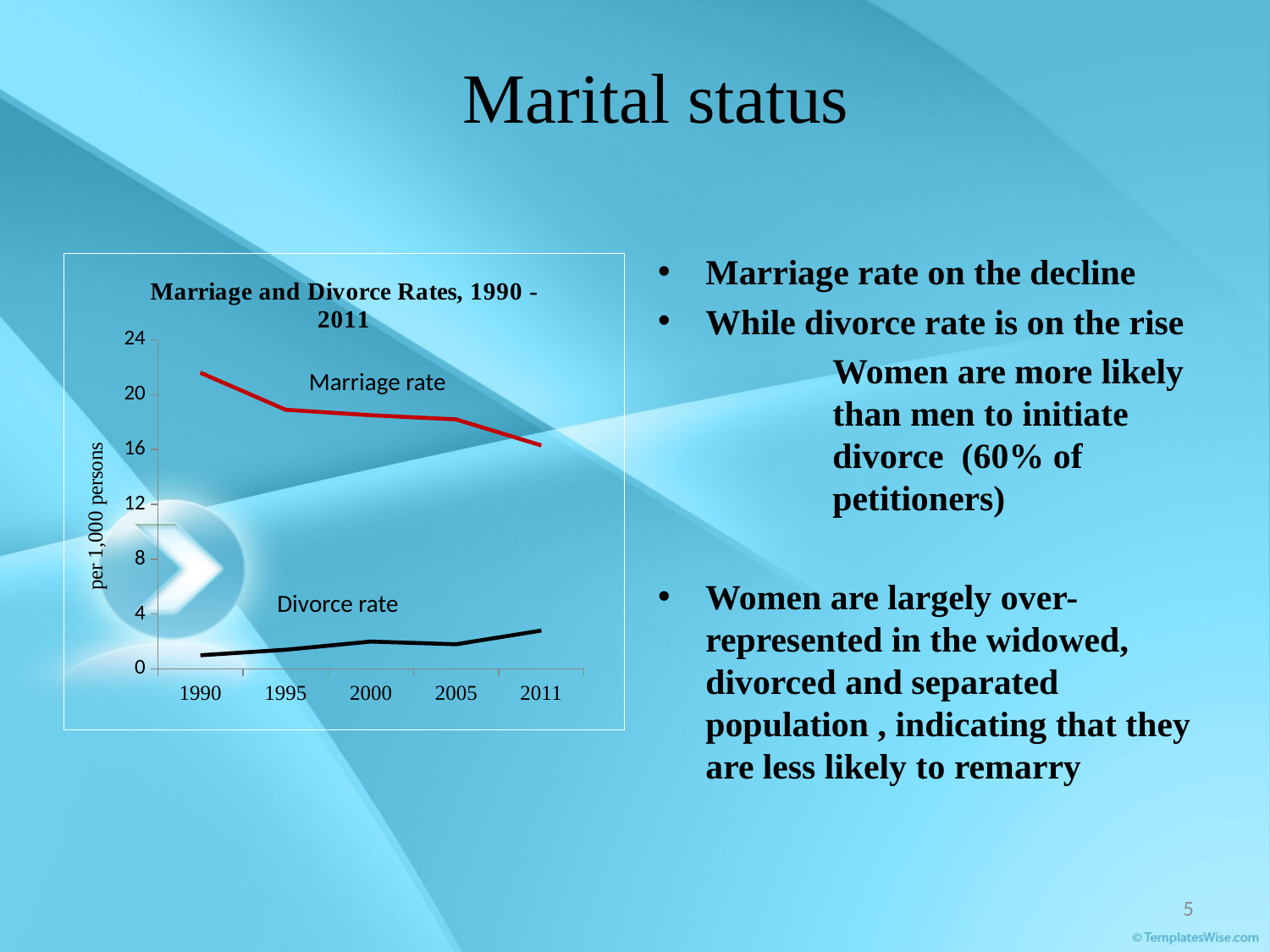
Does the divorce rate rise or fall overall from 1990 to 2011? Rise How many series are plotted in the chart? 2 In which year is the marriage rate lowest? 2011 In which year is the marriage rate highest? 1990 What kind of chart is shown on the slide? Line chart What is the title of the chart? Marriage and Divorce Rates, 1990 - 2011 How many years are marked along the x axis of the chart? 5 Does the marriage rate rise or fall from 1990 to 2011? Fall Is the marriage rate in 1990 greater or less than 20? greater In which year is the divorce rate highest? 2011 What is the label on the vertical axis of the chart? per 1,000 persons Is the divorce rate in 2011 greater or less than 4? less